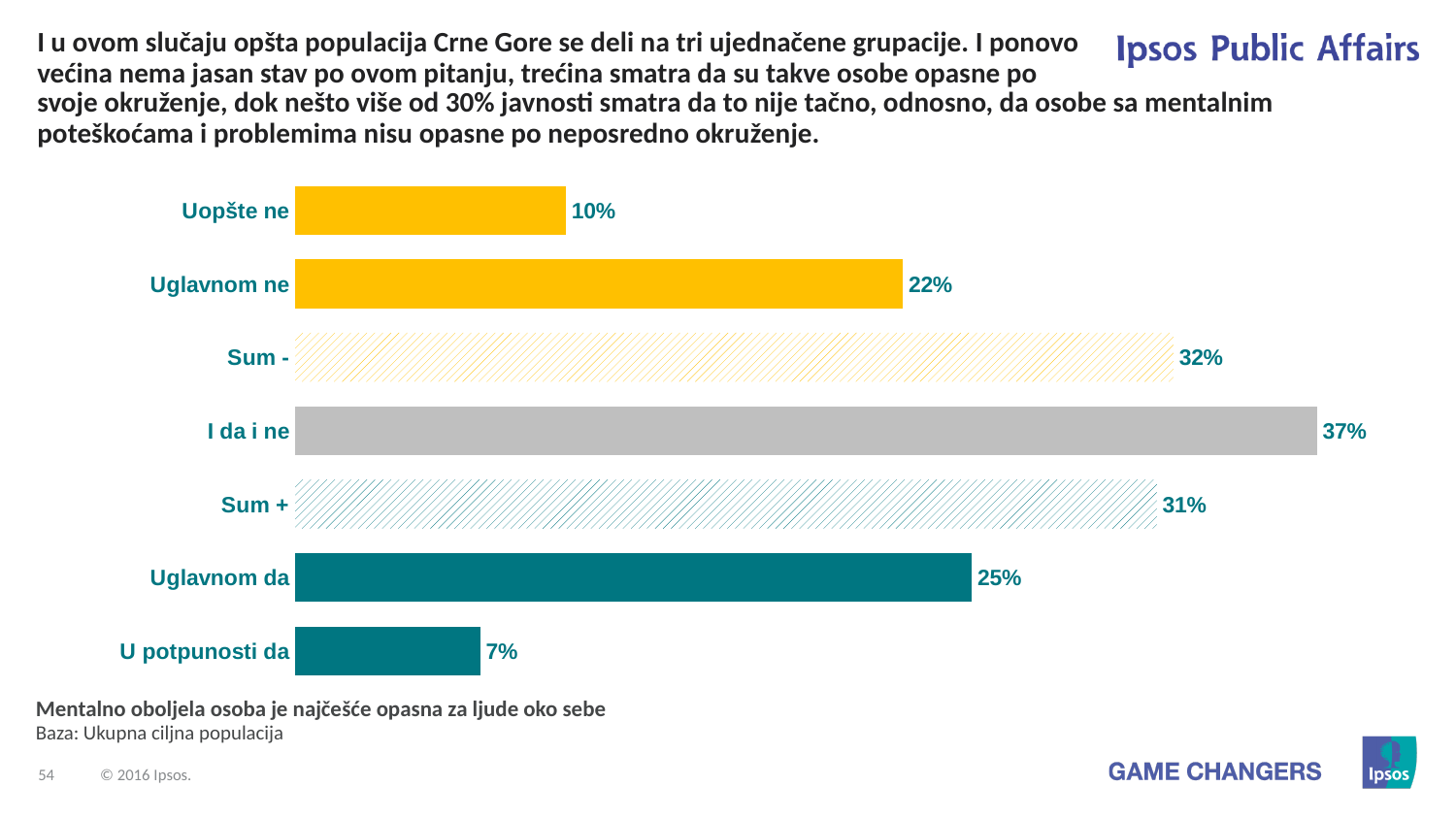
What is the value for "Sum +"? 31% How many categories are shown in the chart? 7 Which bars are drawn with a hatched (striped) pattern? Sum - and Sum + What is the difference between "Uglavnom ne" and "Uopšte ne"? 12% What is the difference between "Sum -" and "Sum +"? 1% What is the value for "Uopšte ne"? 10% Which category has the highest value? I da i ne Which category has the lowest value? U potpunosti da What kind of chart is shown on the slide? Bar chart Which is larger, "Uglavnom da" or "Uglavnom ne"? Uglavnom da What is the value for "Uglavnom da"? 25% What is the value for "I da i ne"? 37%